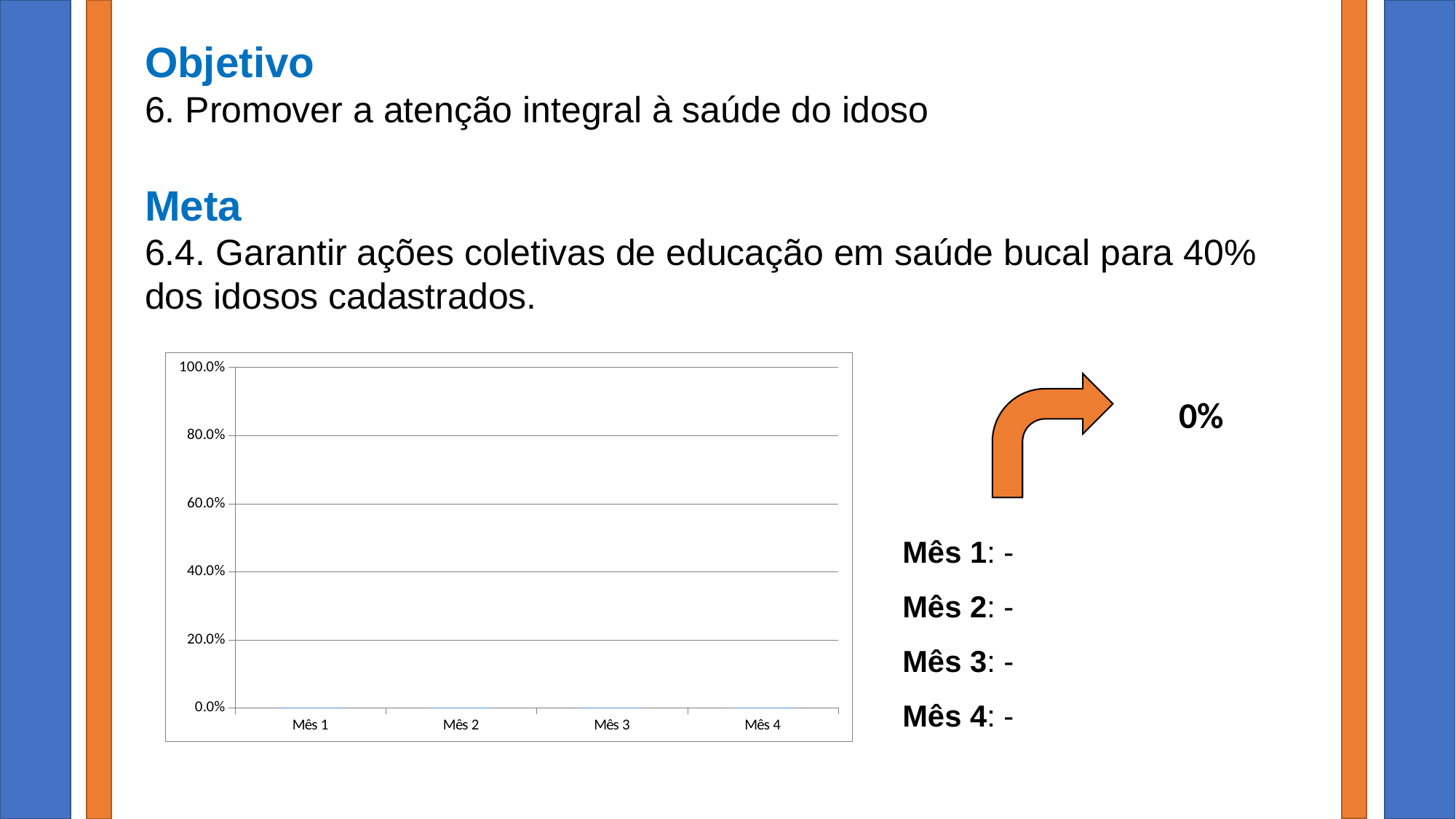
What kind of chart is shown on the slide? bar chart What is the highest value shown on the y axis of the chart? 100.0% What value does the bar for Mês 2 reach on the y axis? 0.0% Is the value for Mês 2 greater or less than 60%? less How many categories are shown on the x axis of the chart? 4 What is the label of the first category on the x axis of the chart? Mês 1 Is the value for Mês 1 greater or less than 20%? less What value does the bar for Mês 3 reach on the y axis? 0.0% Is the value for Mês 4 greater or less than 40%? less Do the values rise, fall, or stay flat from Mês 1 to Mês 4? stay flat